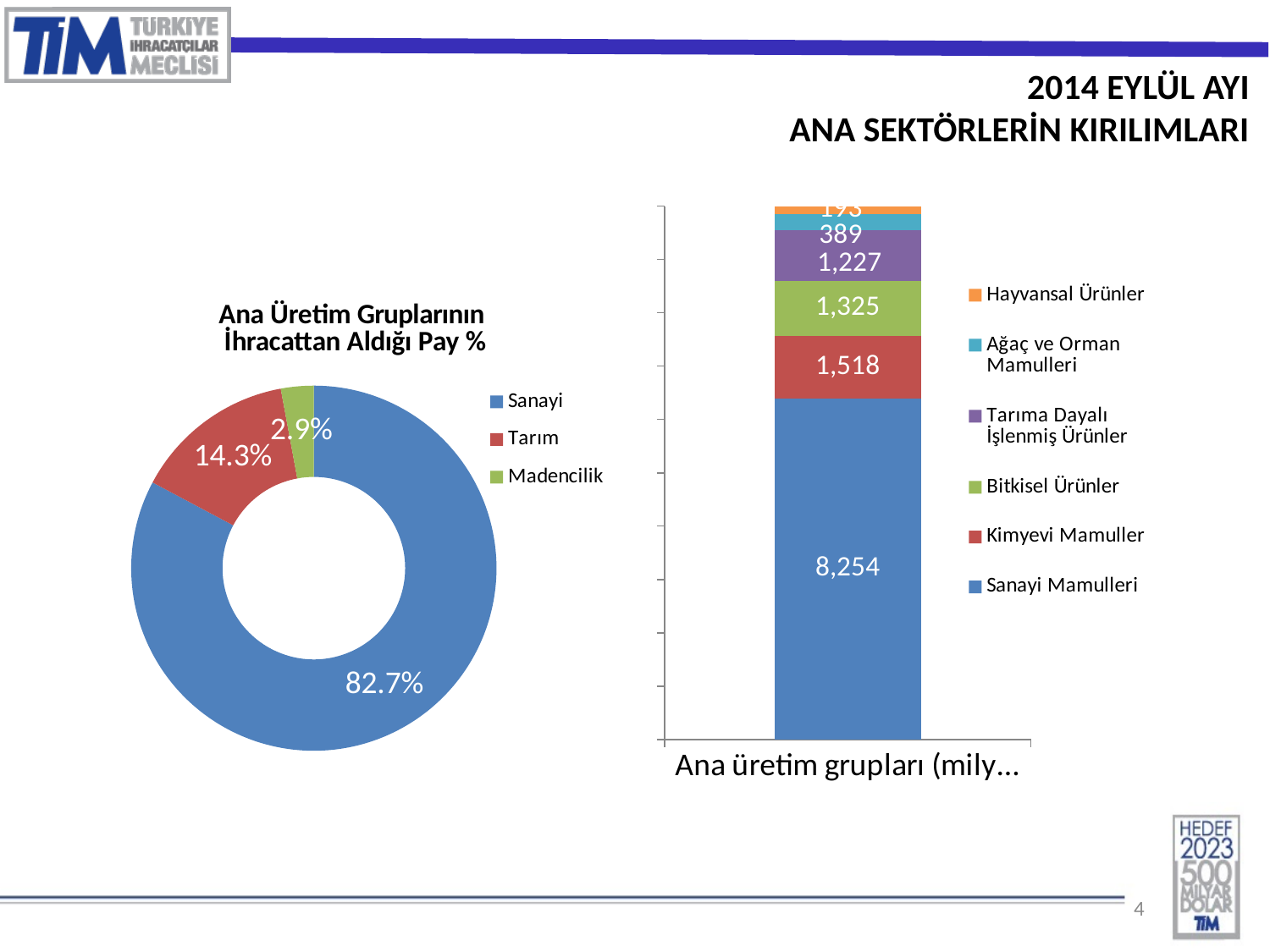
In the donut chart 'Ana Üretim Gruplarının İhracattan Aldığı Pay %', which category has the smallest share? Madencilik In the stacked bar chart on the right, what is the value for Ağaç ve Orman Mamulleri? 389 In the stacked bar chart on the right, what is the value for Bitkisel Ürünler? 1,325 In the stacked bar chart on the right, what is the value for Sanayi Mamulleri? 8,254 In the stacked bar chart on the right, how many series does the legend list? 6 In the stacked bar chart on the right, what is the value for Kimyevi Mamuller? 1,518 In the donut chart 'Ana Üretim Gruplarının İhracattan Aldığı Pay %', what share does Madencilik have? 2.9% In the donut chart 'Ana Üretim Gruplarının İhracattan Aldığı Pay %', what is the difference between the shares of Tarım and Madencilik? 11.4% In the donut chart 'Ana Üretim Gruplarının İhracattan Aldığı Pay %', how many categories does the legend list? 3 In the donut chart 'Ana Üretim Gruplarının İhracattan Aldığı Pay %', what share does Tarım have? 14.3% In the stacked bar chart on the right, which segment is larger: Kimyevi Mamuller or Tarıma Dayalı İşlenmiş Ürünler? Kimyevi Mamuller In the donut chart 'Ana Üretim Gruplarının İhracattan Aldığı Pay %', what share does Sanayi have? 82.7%